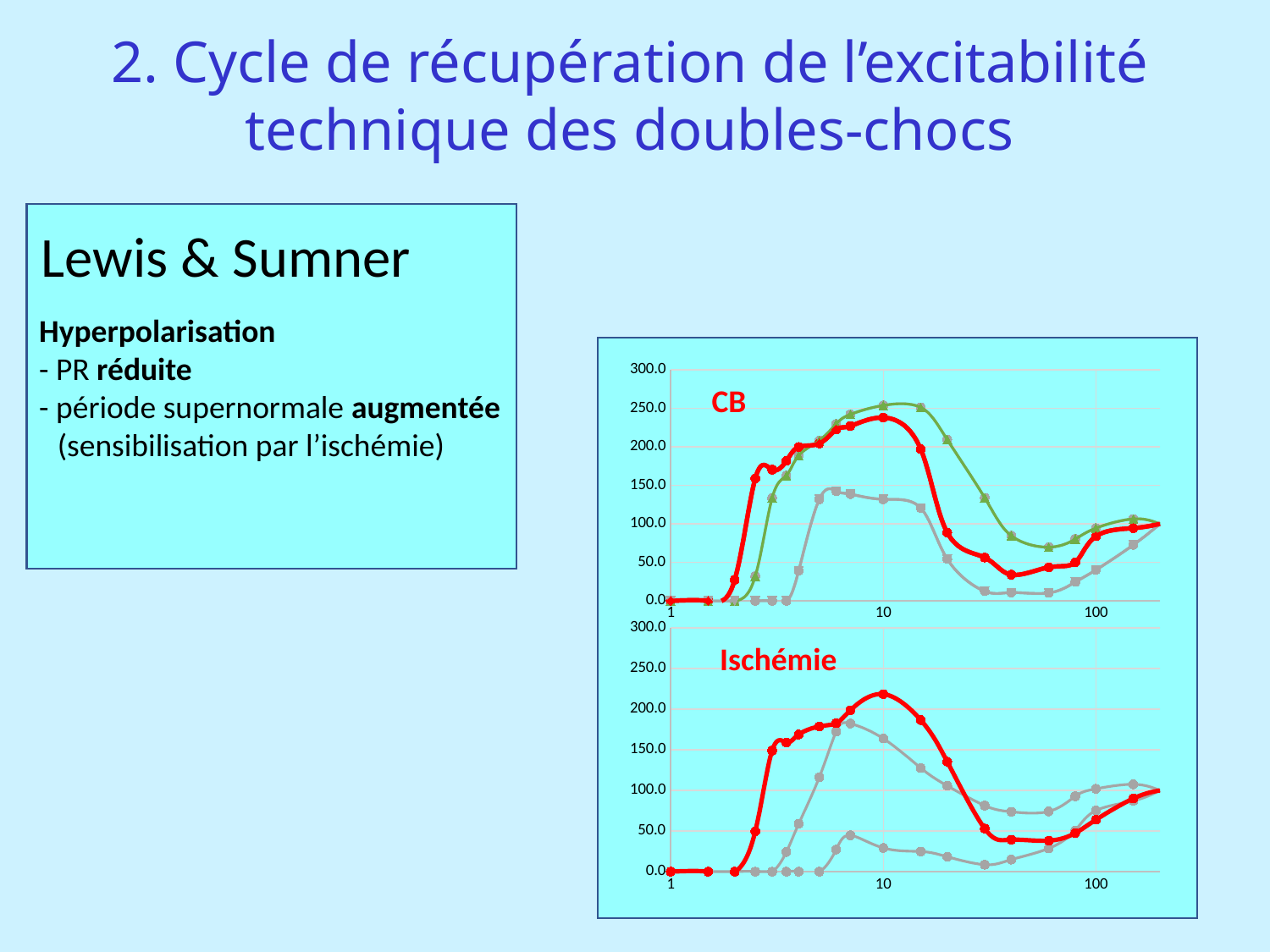
What is the highest value shown on the y axis of the CB chart? 300.0 On the CB chart, which line reaches a higher peak, the red line or the grey line? the red line On the Ischémie chart, is the peak value of the red line greater or less than 200.0? greater What are the labels of the two charts on the slide? CB and Ischémie What kind of chart is the bottom chart labelled Ischémie? line chart What kind of chart is the top chart labelled CB? line chart How many lines are plotted on the CB chart? 3 How many lines are plotted on the Ischémie chart? 3 On the Ischémie chart, is the peak value of the lowest grey line greater or less than 100.0? less On the CB chart, is the peak value of the grey line greater or less than 100.0? greater On the Ischémie chart, does the red line rise or fall between x = 1 and x = 10? rise